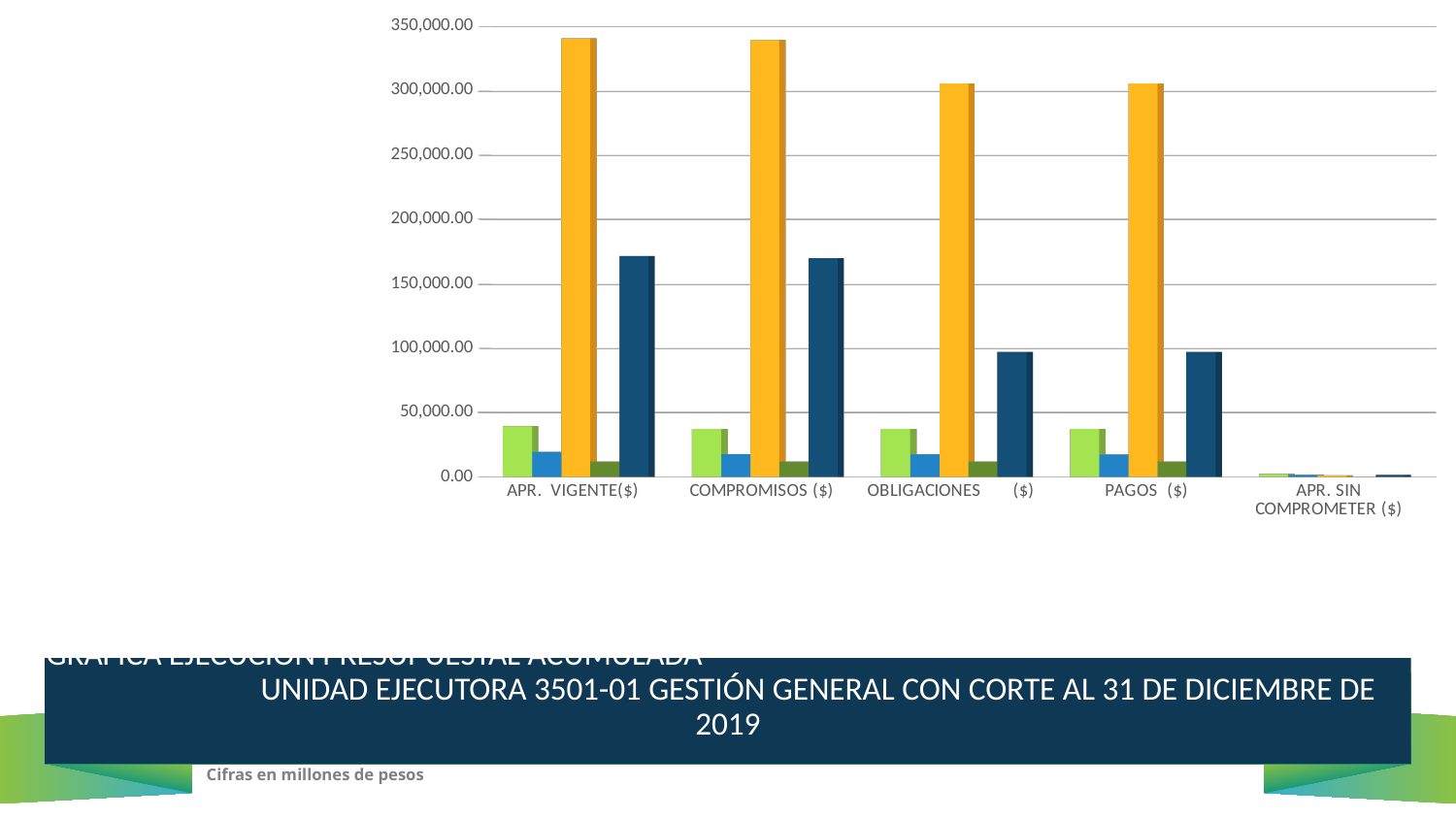
Is the light green bar for COMPROMISOS ($) greater or less than 50,000.00? less Which is larger: the dark blue bar for COMPROMISOS ($) or the dark blue bar for PAGOS ($)? COMPROMISOS ($) What kind of chart is shown on the slide? bar chart Is the dark blue bar for OBLIGACIONES ($) greater or less than 150,000.00? less Which category has the lowest values across all bars in the chart? APR. SIN COMPROMETER ($) Is the orange bar for PAGOS ($) greater or less than 250,000.00? greater Do the orange bars rise or fall moving from APR. VIGENTE($) to APR. SIN COMPROMETER ($) along the x axis? fall How many categories are shown on the x axis of the chart? 5 Which is larger: the orange bar for APR. VIGENTE($) or the orange bar for OBLIGACIONES ($)? APR. VIGENTE($) What unit note is printed below the chart title? Cifras en millones de pesos